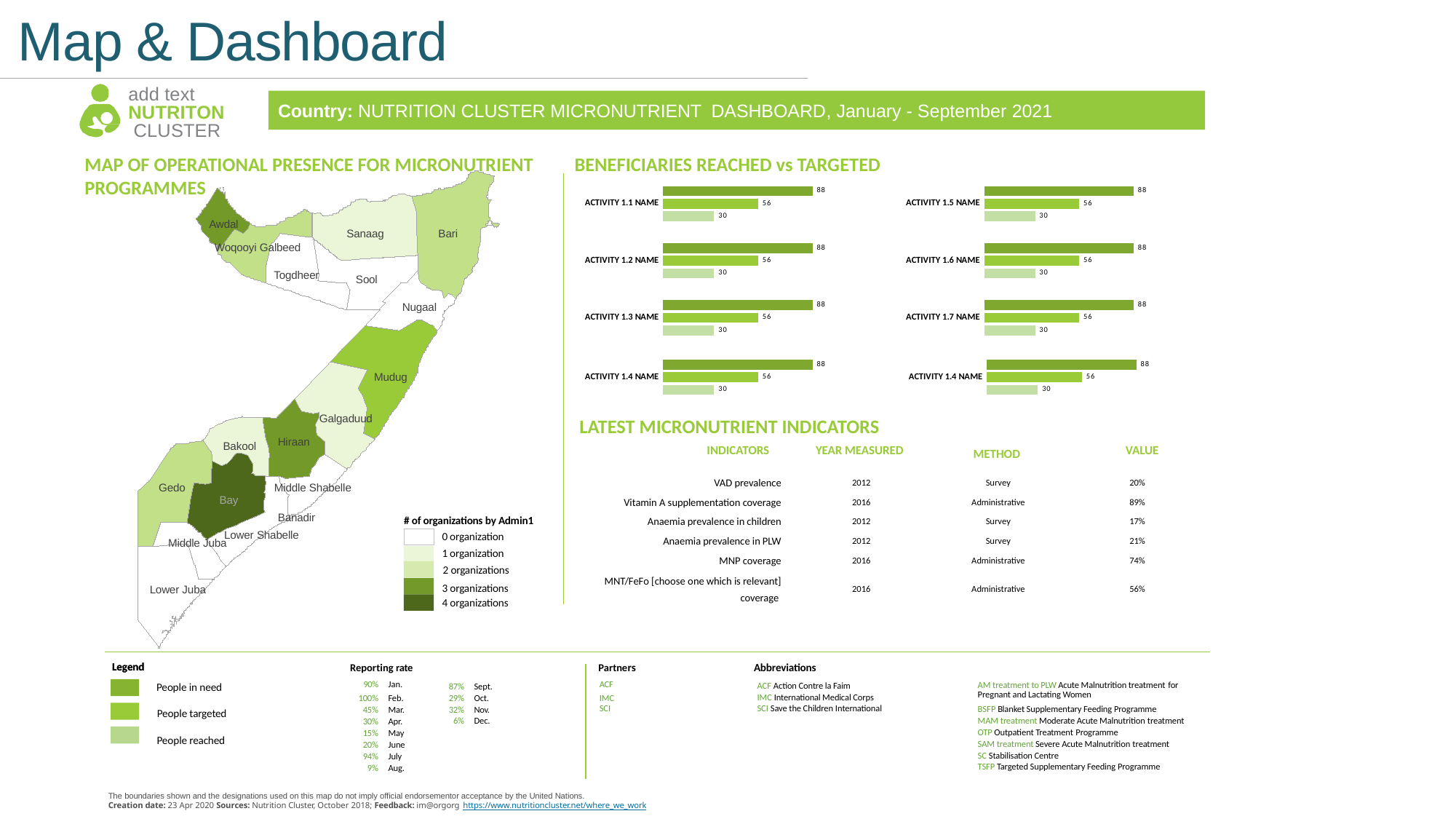
How many categories are listed in the map legend '# of organizations by Admin1'? 5 In the Beneficiaries Reached vs Targeted chart, what is the difference between the top bar and the middle bar for ACTIVITY 1.6 NAME? 32 What kind of chart is used in the Beneficiaries Reached vs Targeted section? Bar chart In the Beneficiaries Reached vs Targeted chart, how many bars are shown for each activity? 3 In the Beneficiaries Reached vs Targeted chart, what is the value of the middle bar for ACTIVITY 1.3 NAME? 56 In the Beneficiaries Reached vs Targeted chart, what is the difference between the middle bar and the bottom bar for ACTIVITY 1.7 NAME? 26 In the Beneficiaries Reached vs Targeted chart, what is the value of the longest bar for ACTIVITY 1.1 NAME? 88 In the Beneficiaries Reached vs Targeted chart, what is the value of the shortest bar for ACTIVITY 1.5 NAME? 30 According to the Legend at the bottom of the slide, what does the darkest green bar colour represent? People in need How many activity charts are shown in the Beneficiaries Reached vs Targeted section? 8 In the Beneficiaries Reached vs Targeted chart, what is the difference between the longest and shortest bars for ACTIVITY 1.2 NAME? 58 In the Beneficiaries Reached vs Targeted chart for ACTIVITY 1.7 NAME, which is larger, the top bar or the bottom bar? The top bar